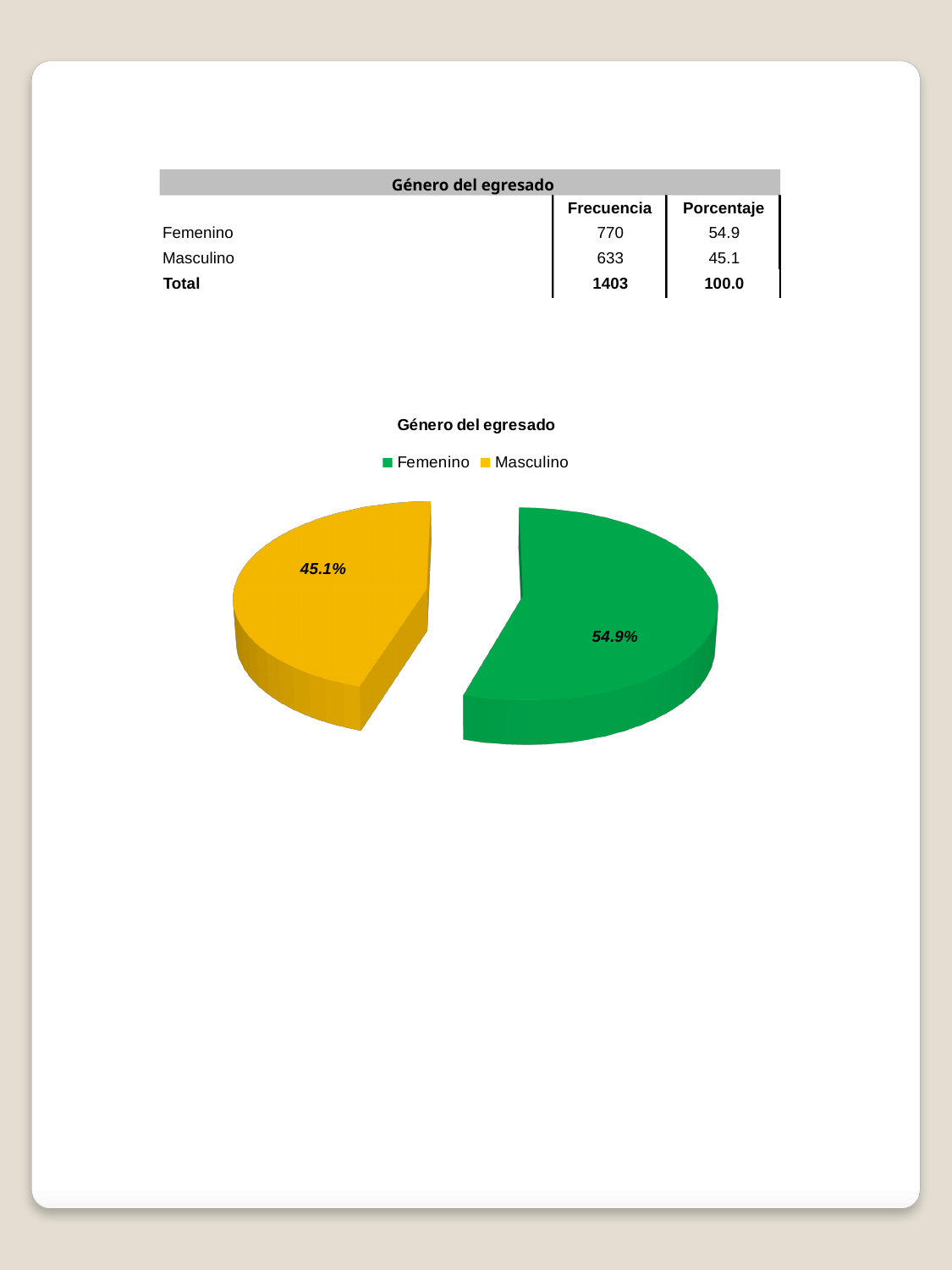
How many slices does the pie chart have? 2 Which slice is the largest in the pie chart? Femenino What type of chart is shown on the slide? pie chart Which slice is the smallest in the pie chart? Masculino What is the difference in percentage points between the Femenino and Masculino slices? 9.8 What colour is the Masculino slice in the pie chart? yellow Which is larger, the Femenino slice or the Masculino slice? Femenino What share of the pie does Masculino represent? 45.1% How many series does the chart legend list? 2 What is the title of the chart? Género del egresado What share of the pie does Femenino represent? 54.9%